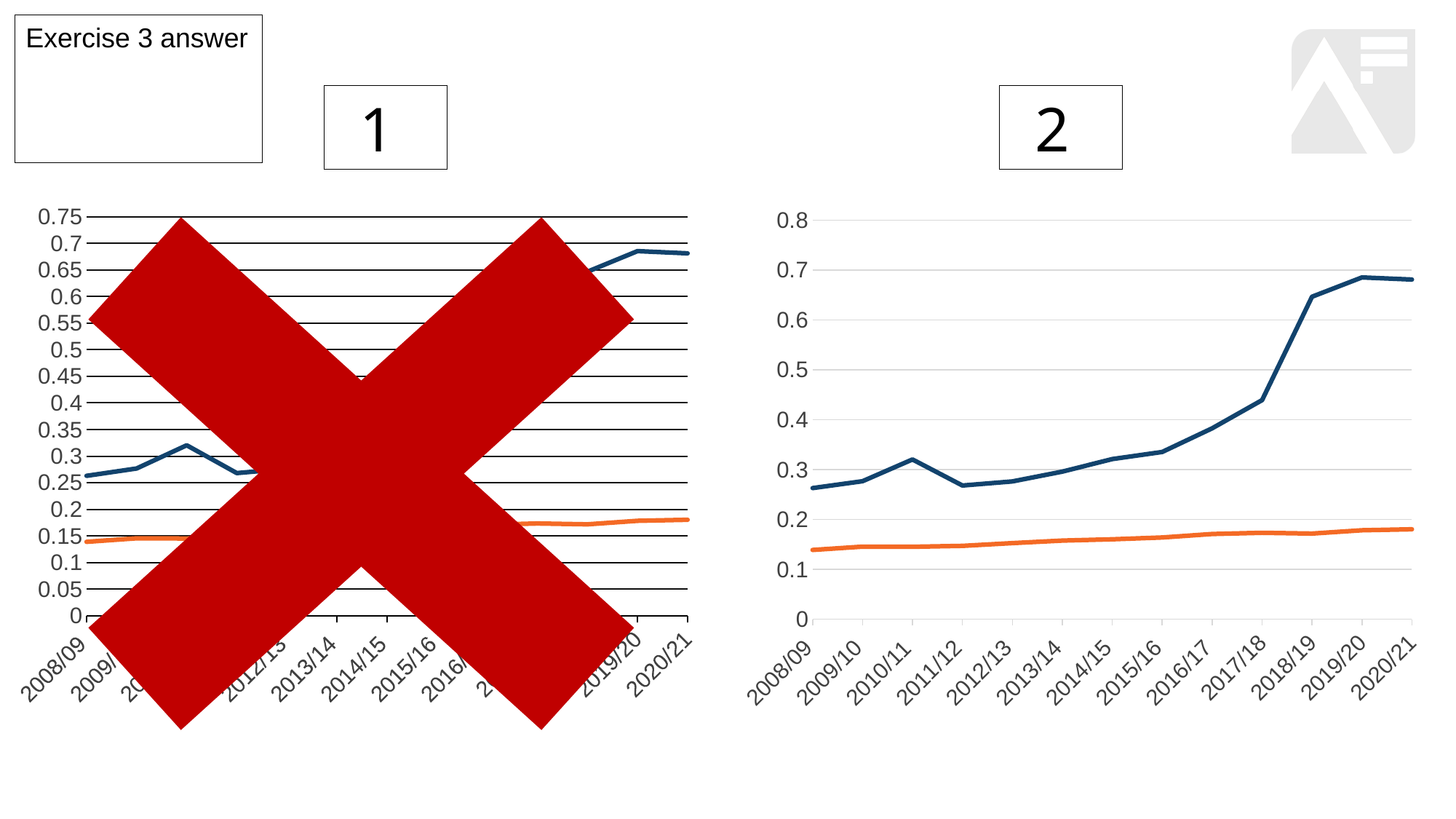
In chart 2, is the value of the orange line for 2020/21 greater or less than 0.2? less In chart 2, is the value of the dark blue line for 2008/09 greater or less than 0.3? less Which of the two charts on the slide is crossed out with a red X? chart 1 In chart 2, which line has the higher value in 2020/21, the dark blue line or the orange line? the dark blue line In chart 2, is the value of the dark blue line for 2020/21 greater or less than 0.6? greater How many lines are plotted in chart 2? 2 What is the highest tick shown on the y axis of chart 2? 0.8 In chart 2, does the dark blue line generally rise or fall from 2008/09 to 2020/21? rise How many years are shown on the x axis of chart 2? 13 What kind of chart is chart 2 (on the right of the slide)? line chart